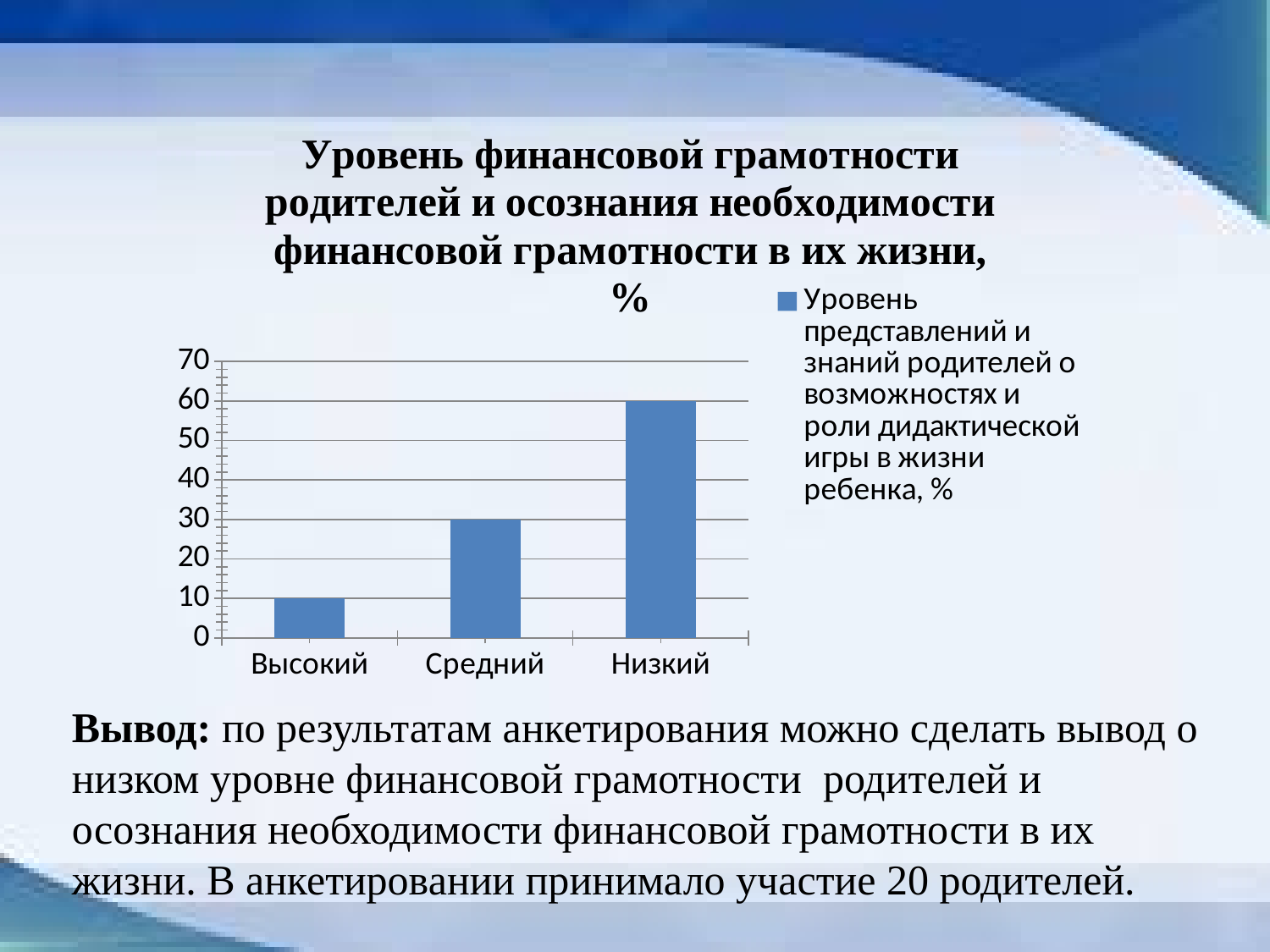
Which category has the highest value? Низкий What type of chart is shown on the slide? bar chart What is the difference between the values for Низкий and Средний? 30 How many series does the chart legend list? 1 Which is larger, the value for Средний or the value for Высокий? Средний What is the value for the category Низкий? 60 Is the value for Низкий greater or less than 50? greater What is the value for the category Средний? 30 What is the value for the category Высокий? 10 How many categories are shown on the x axis of the chart? 3 Do the values rise or fall moving from Высокий to Низкий along the x axis? rise Which category has the lowest value? Высокий